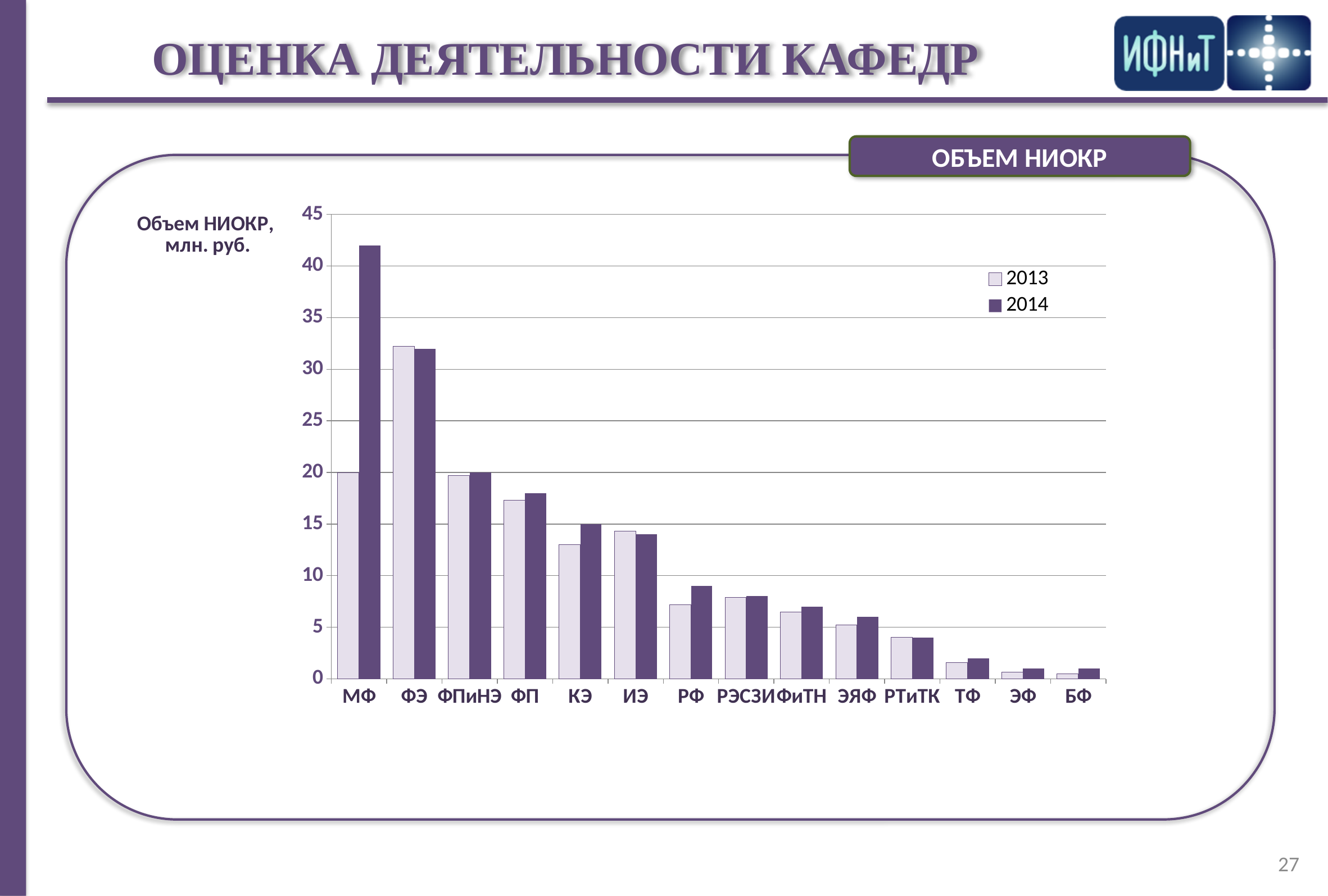
What are the two entries in the chart legend? 2013 and 2014 Is the 2013 value for ФЭ greater or less than 30? greater Which is larger: the 2013 value for КЭ or the 2013 value for ИЭ? ИЭ Which department has the highest value for 2013? ФЭ For МФ, which year has the larger value, 2013 or 2014? 2014 What kind of chart is shown on the slide? bar chart How many departments (categories) are shown on the x axis? 14 Is the 2014 value for РФ greater or less than 10? less Is the 2014 value for МФ greater or less than 40? greater How many series does the legend list? 2 Which department has the highest value for 2014? МФ